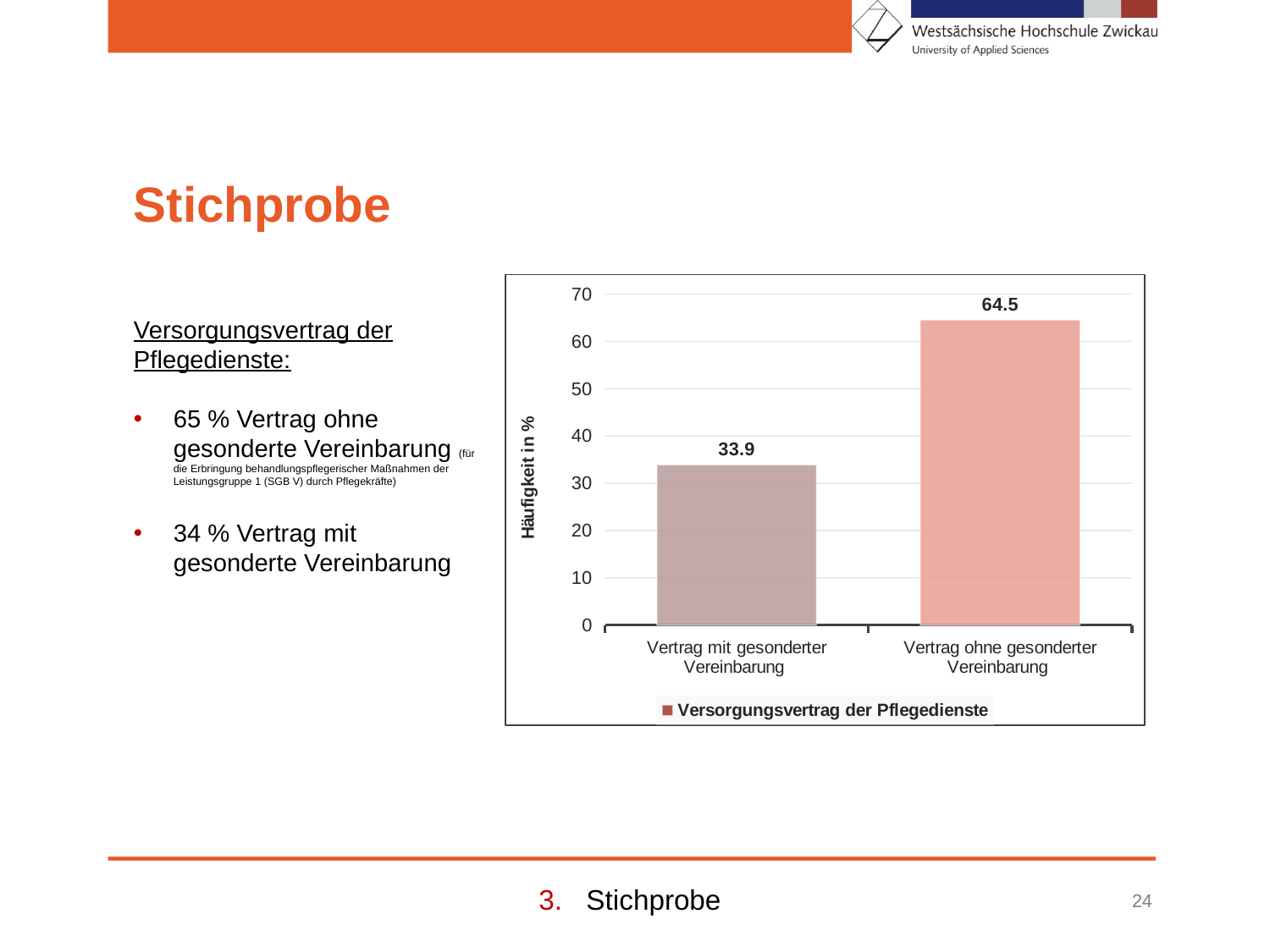
Which category has the highest value? Vertrag ohne gesonderter Vereinbarung What is the difference between the values for "Vertrag ohne gesonderter Vereinbarung" and "Vertrag mit gesonderter Vereinbarung"? 30.6 Which is larger: the value for "Vertrag mit gesonderter Vereinbarung" or for "Vertrag ohne gesonderter Vereinbarung"? Vertrag ohne gesonderter Vereinbarung What is the value for "Vertrag mit gesonderter Vereinbarung"? 33.9 Is the value for "Vertrag mit gesonderter Vereinbarung" greater or less than 40? less How many series does the legend list? 1 What kind of chart is shown? bar chart What is the label of the y axis? Häufigkeit in % What is the value for "Vertrag ohne gesonderter Vereinbarung"? 64.5 How many categories are shown on the x axis? 2 Is the value for "Vertrag ohne gesonderter Vereinbarung" greater or less than 60? greater Which category has the lowest value? Vertrag mit gesonderter Vereinbarung